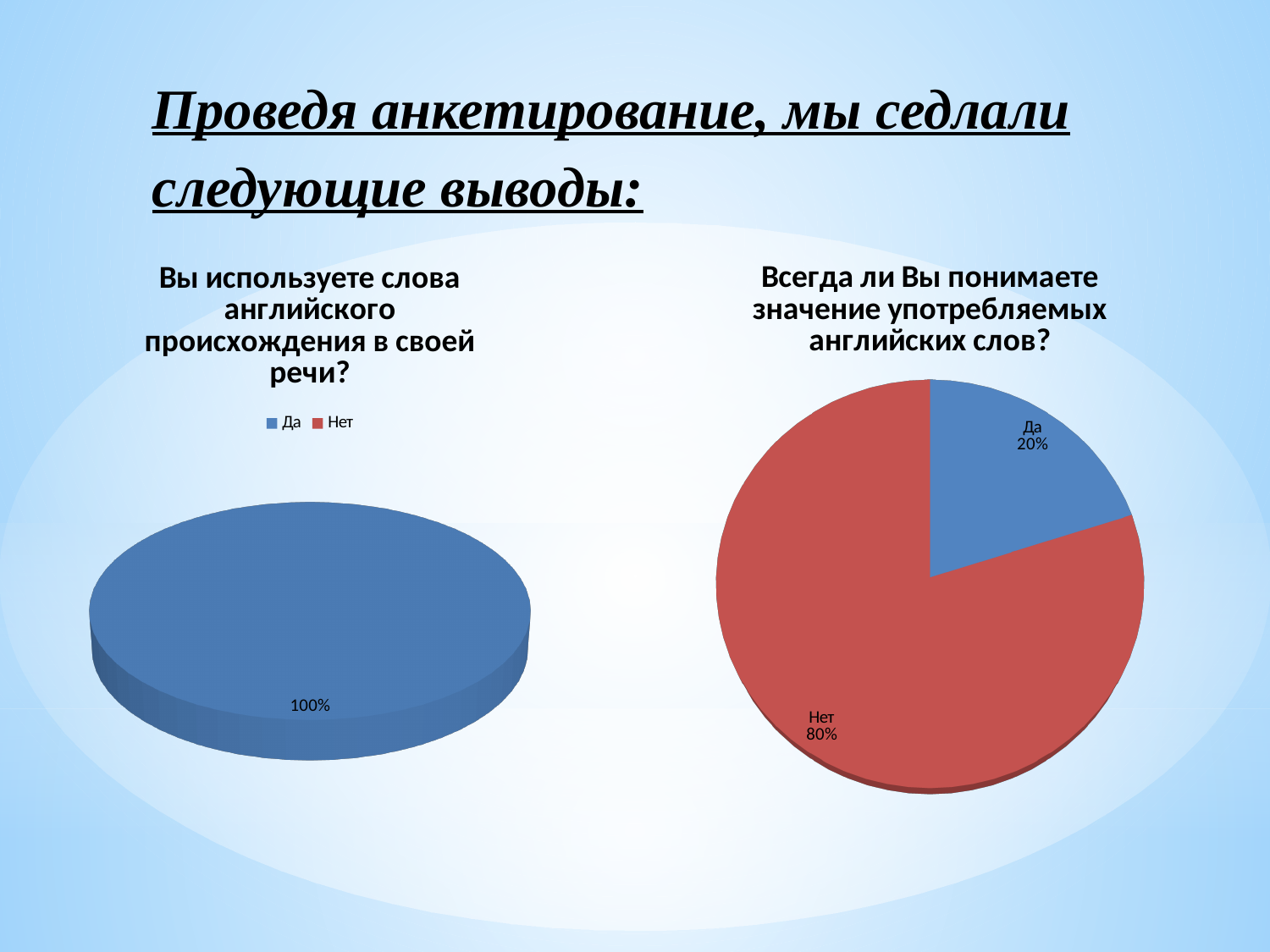
In the right chart, which slice is the smallest? Да In the left chart, which legend entry is shown in blue? Да In the right chart ("Всегда ли Вы понимаете значение употребляемых английских слов?"), what is the share for "Нет"? 80% What kind of chart is the left chart titled "Вы используете слова английского происхождения в своей речи?"? pie chart In the right chart, what is the difference between the shares for "Нет" and "Да"? 60% In the right chart, which slice is the largest? Нет In the right chart, which is larger: the share for "Да" or the share for "Нет"? Нет How many entries does the legend of the left chart list? 2 How many slices does the right chart have? 2 In the right chart ("Всегда ли Вы понимаете значение употребляемых английских слов?"), what is the share for "Да"? 20% What kind of chart is the right chart titled "Всегда ли Вы понимаете значение употребляемых английских слов?"? pie chart In the left chart ("Вы используете слова английского происхождения в своей речи?"), what percentage is shown on the pie? 100%